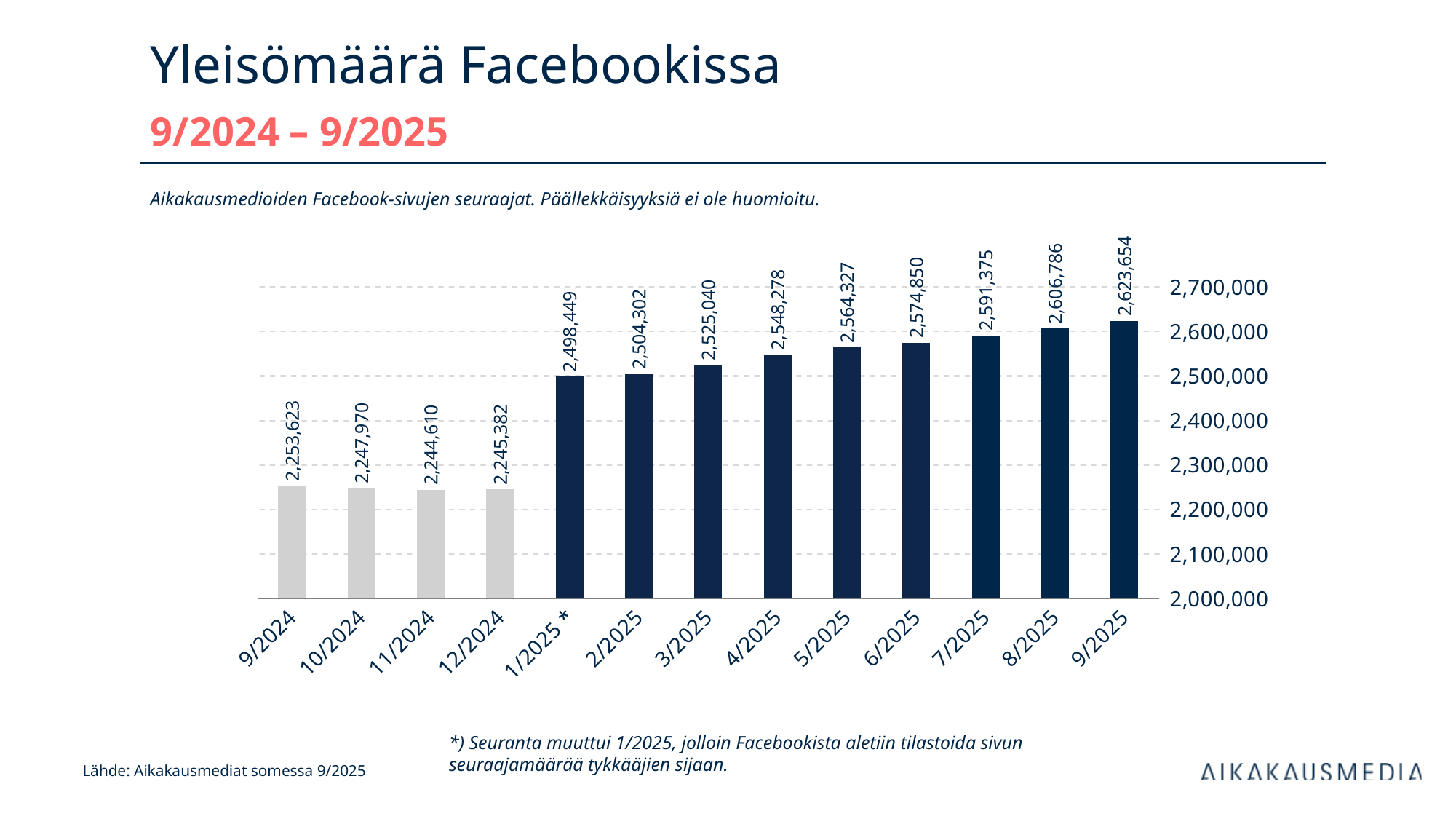
Which is larger, the value for 10/2024 or the value for 2/2025? 2/2025 Which month has the highest value? 9/2025 Which month has the lowest value? 11/2024 What is the value for 9/2025? 2,623,654 What is the value for 12/2024? 2,245,382 Is the value for 9/2024 greater or less than 2,300,000? less What kind of chart is shown on the slide? bar chart How many bars are shown in the chart? 13 What is the difference between the values for 9/2025 and 9/2024? 370,031 Do the values rise or fall from 1/2025 * to 9/2025? rise What is the value for 1/2025 *? 2,498,449 What is the difference between the values for 1/2025 * and 12/2024? 253,067